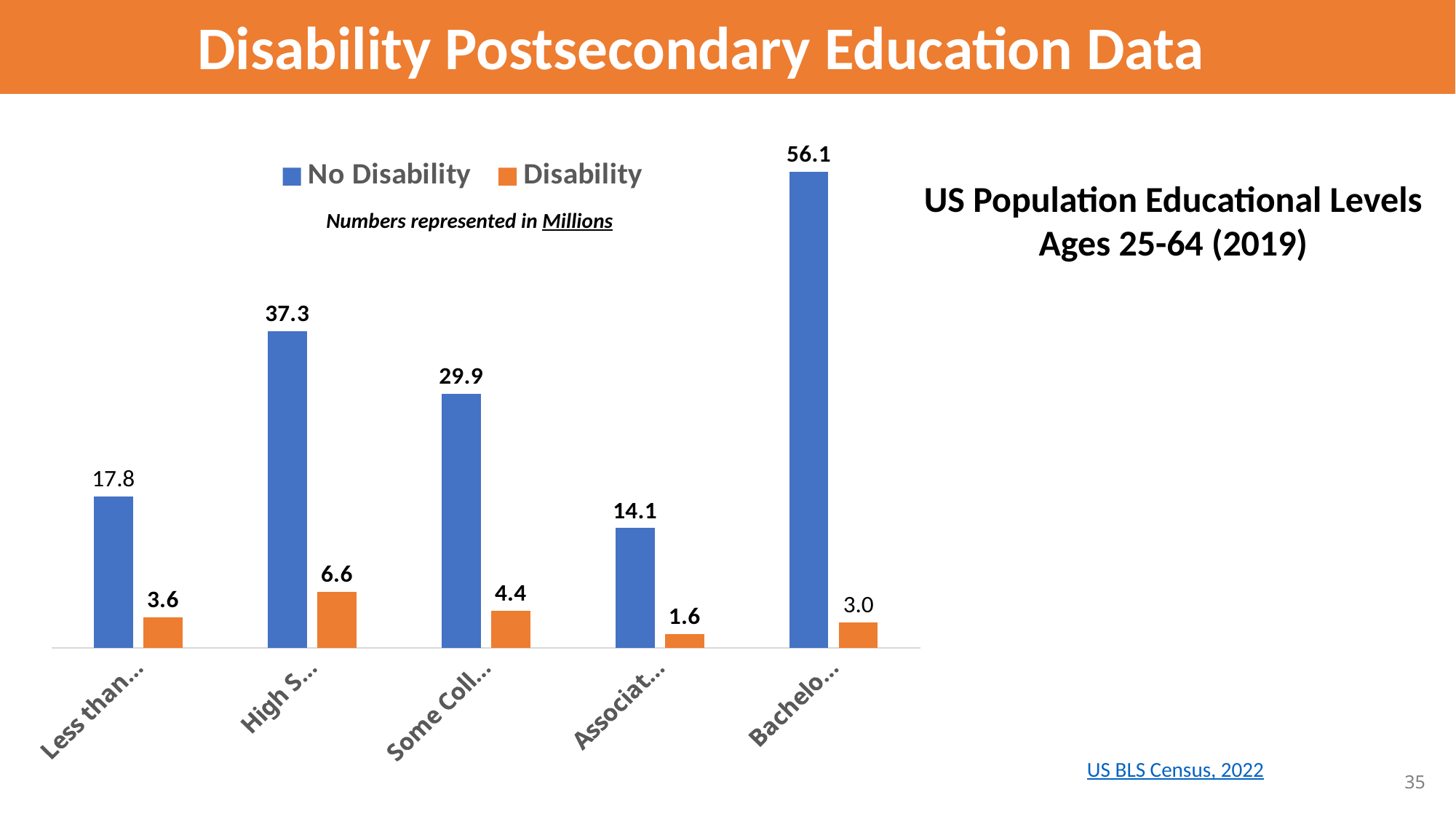
What is the No Disability value for the second category (labelled 'High S...')? 37.3 How many series does the chart legend list? 2 What is the Disability value for the third category (labelled 'Some Coll...')? 4.4 How many categories are shown along the x axis of the chart? 5 Which category has the highest No Disability value? Bachelo... (the fifth category) What is the Disability value for the fifth category (labelled 'Bachelo...')? 3.0 Which is larger: the Disability value for 'High S...' or the Disability value for 'Less than...'? High S... What type of chart is shown on the slide? bar chart What is the difference between the No Disability and Disability values for the first category (labelled 'Less than...')? 14.2 Which colour represents the Disability series in the chart? orange Which category has the lowest Disability value? Associat... (the fourth category) What unit are the numbers in the chart represented in, according to the note under the legend? Millions